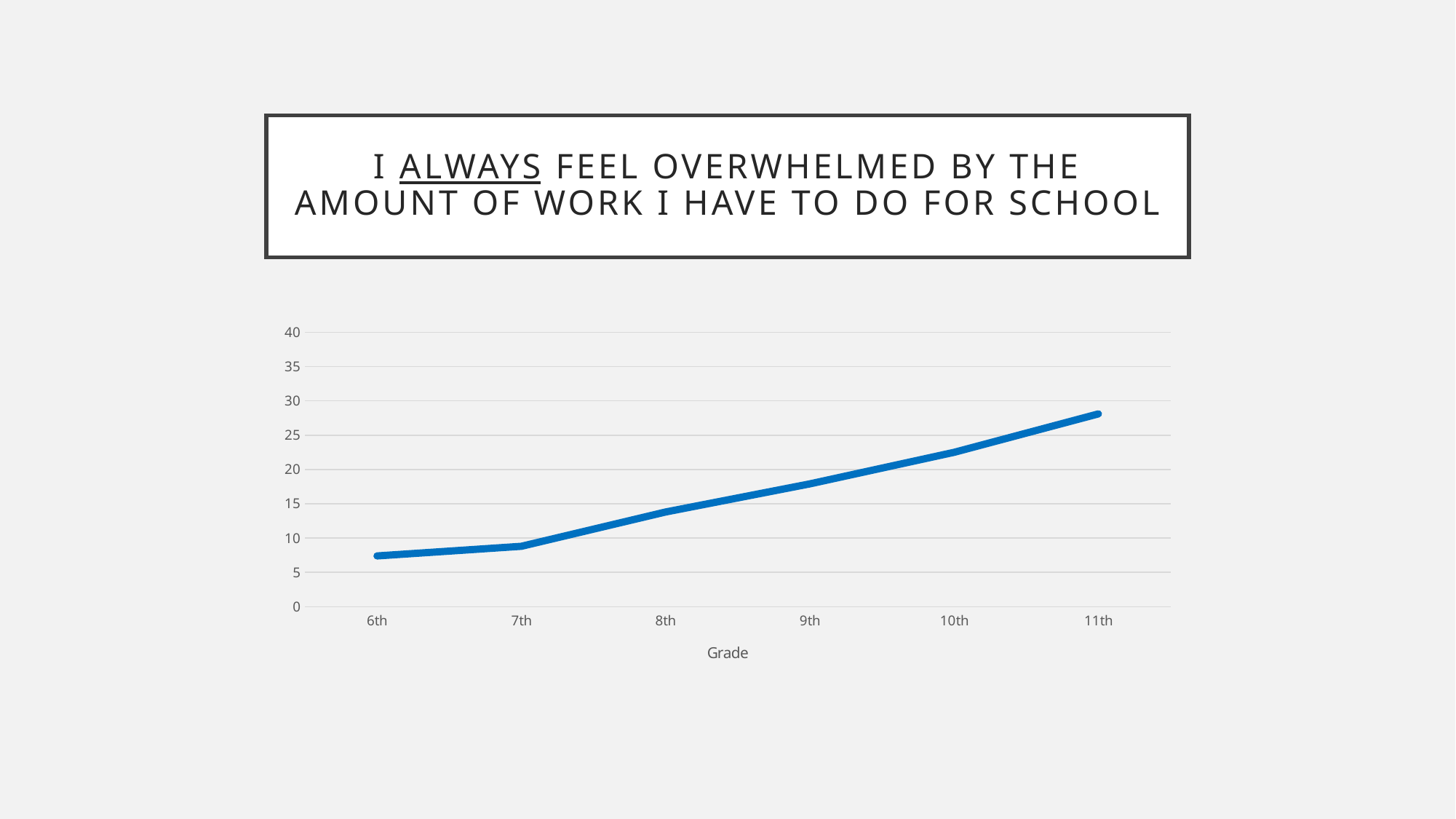
Is the value for 11th grade greater or less than 25? greater Do the values rise or fall from 6th grade to 11th grade? rise What kind of chart is shown on the slide? line chart Which grade has the highest value? 11th Is the value for 11th grade greater or less than 30? less What is the label of the x axis? Grade Which is larger, the value for 9th grade or the value for 7th grade? 9th Is the value for 8th grade greater or less than 10? greater How many grade levels are plotted on the x axis? 6 Which grade has the lowest value? 6th